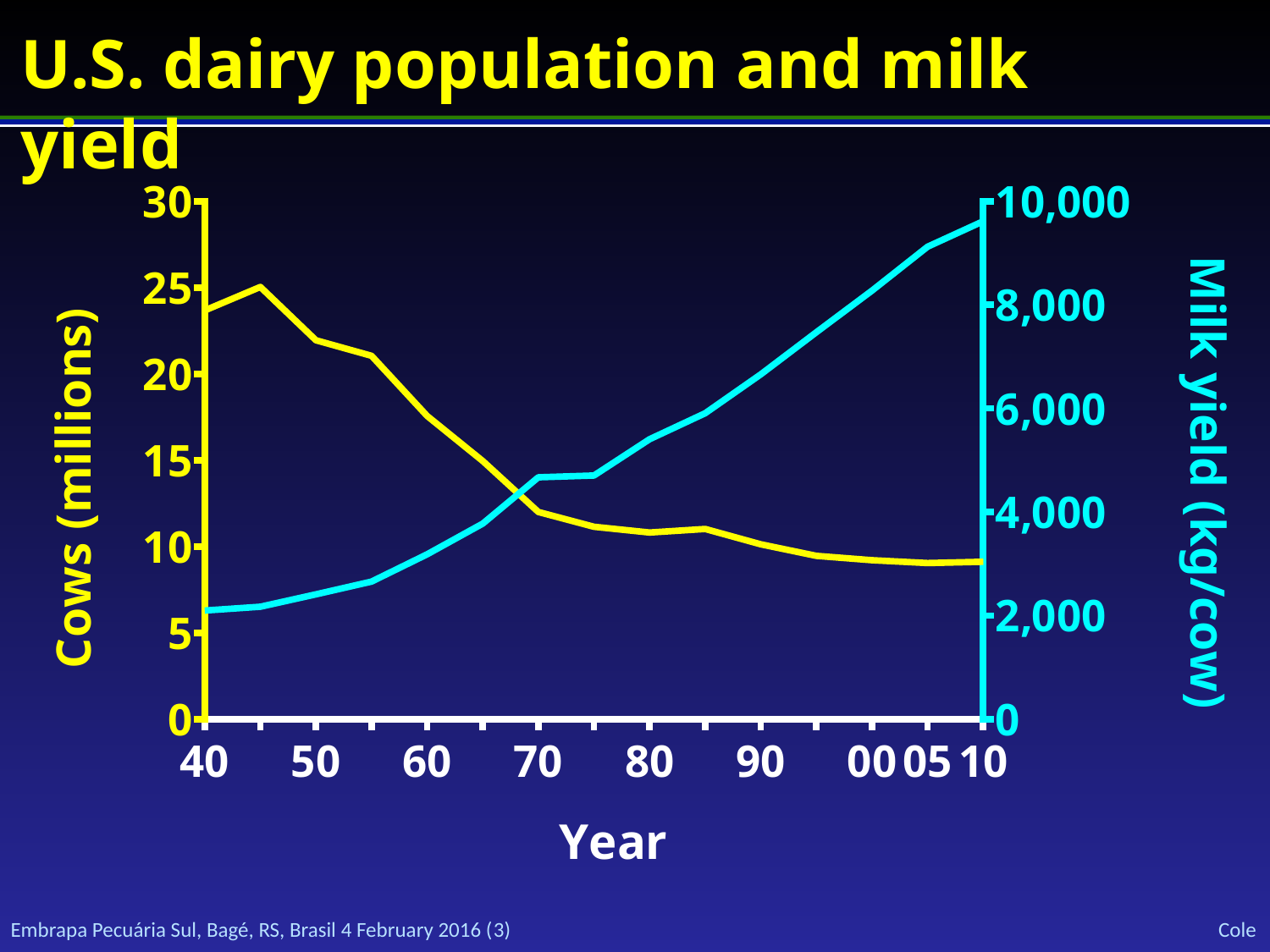
What kind of chart is shown on the slide? line chart What is the label of the left vertical axis? Cows (millions) Does the milk yield (cyan line) rise or fall overall from 1940 to 2010? rise Does the number of cows (yellow line) rise or fall overall from 1940 to 2010? fall In which year shown on the x axis is the milk yield highest? 10 Which year has more cows, 1940 or 2010? 1940 Is the number of cows in 1940 greater or less than 20 million? greater Is the milk yield in 1980 greater or less than 6,000 kg/cow? less Is the milk yield in 2010 greater or less than 8,000 kg/cow? greater How many data series are plotted on the chart? 2 What is the title of the chart? U.S. dairy population and milk yield